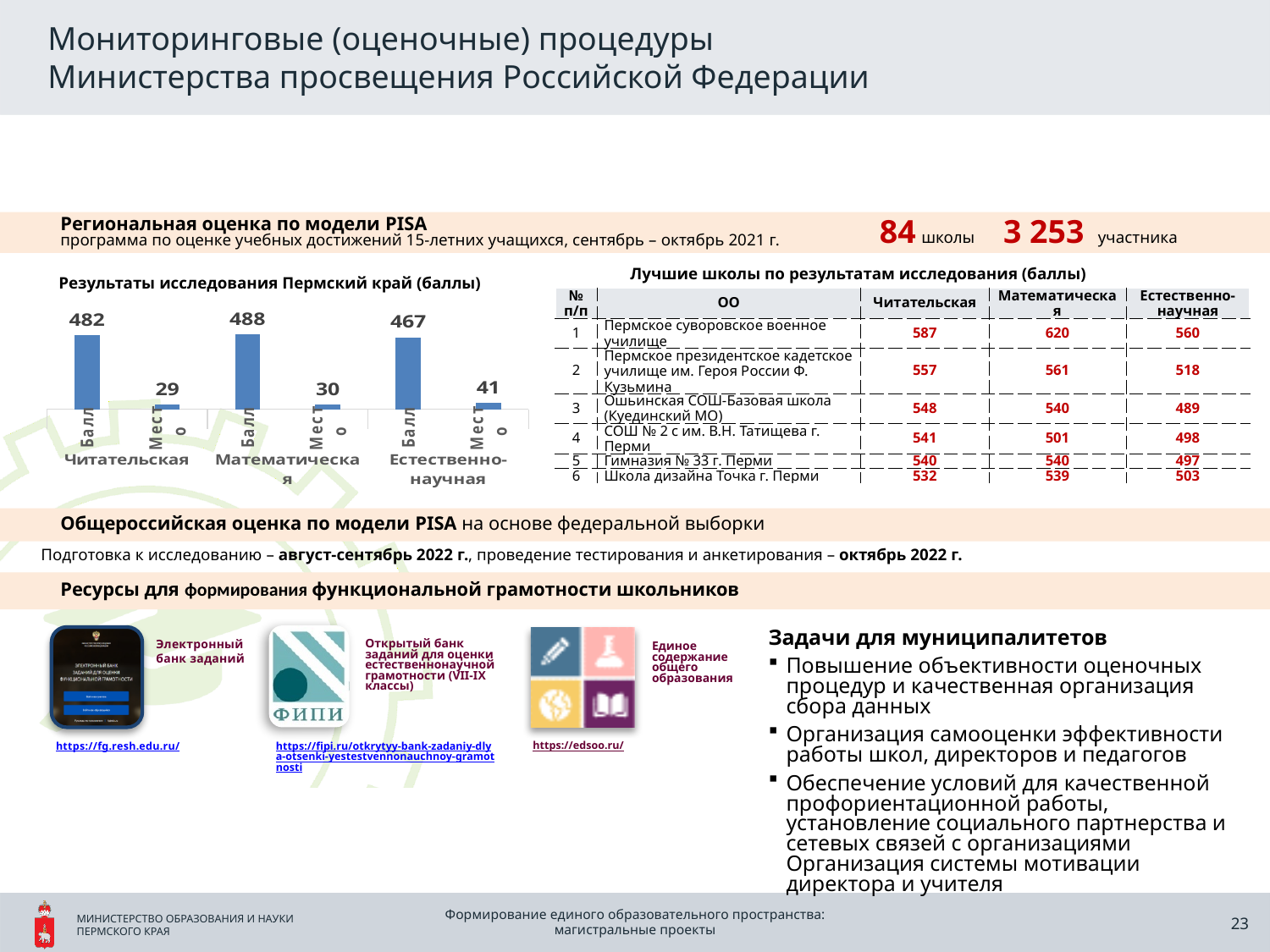
In the chart 'Результаты исследования Пермский край (баллы)', what is the rank (Место) for Читательская? 29 In the chart 'Результаты исследования Пермский край (баллы)', what is the score (Балл) for Математическая? 488 How many bars are plotted in the chart 'Результаты исследования Пермский край (баллы)'? 6 In the chart 'Результаты исследования Пермский край (баллы)', what is the score (Балл) for Читательская? 482 In the chart 'Результаты исследования Пермский край (баллы)', what is the difference between the Математическая score and the Естественно-научная score? 21 In the chart 'Результаты исследования Пермский край (баллы)', what is the score (Балл) for Естественно-научная? 467 In the chart 'Результаты исследования Пермский край (баллы)', which area has the highest score (Балл)? Математическая In the chart 'Результаты исследования Пермский край (баллы)', what is the difference between the rank (Место) for Естественно-научная and the rank for Читательская? 12 In the chart 'Результаты исследования Пермский край (баллы)', what is the rank (Место) for Естественно-научная? 41 What type of chart is used to show the Perm Krai PISA results (Результаты исследования Пермский край)? bar chart In the chart 'Результаты исследования Пермский край (баллы)', which area has the lowest score (Балл)? Естественно-научная In the chart 'Результаты исследования Пермский край (баллы)', which is larger: the score for Читательская or the score for Естественно-научная? Читательская